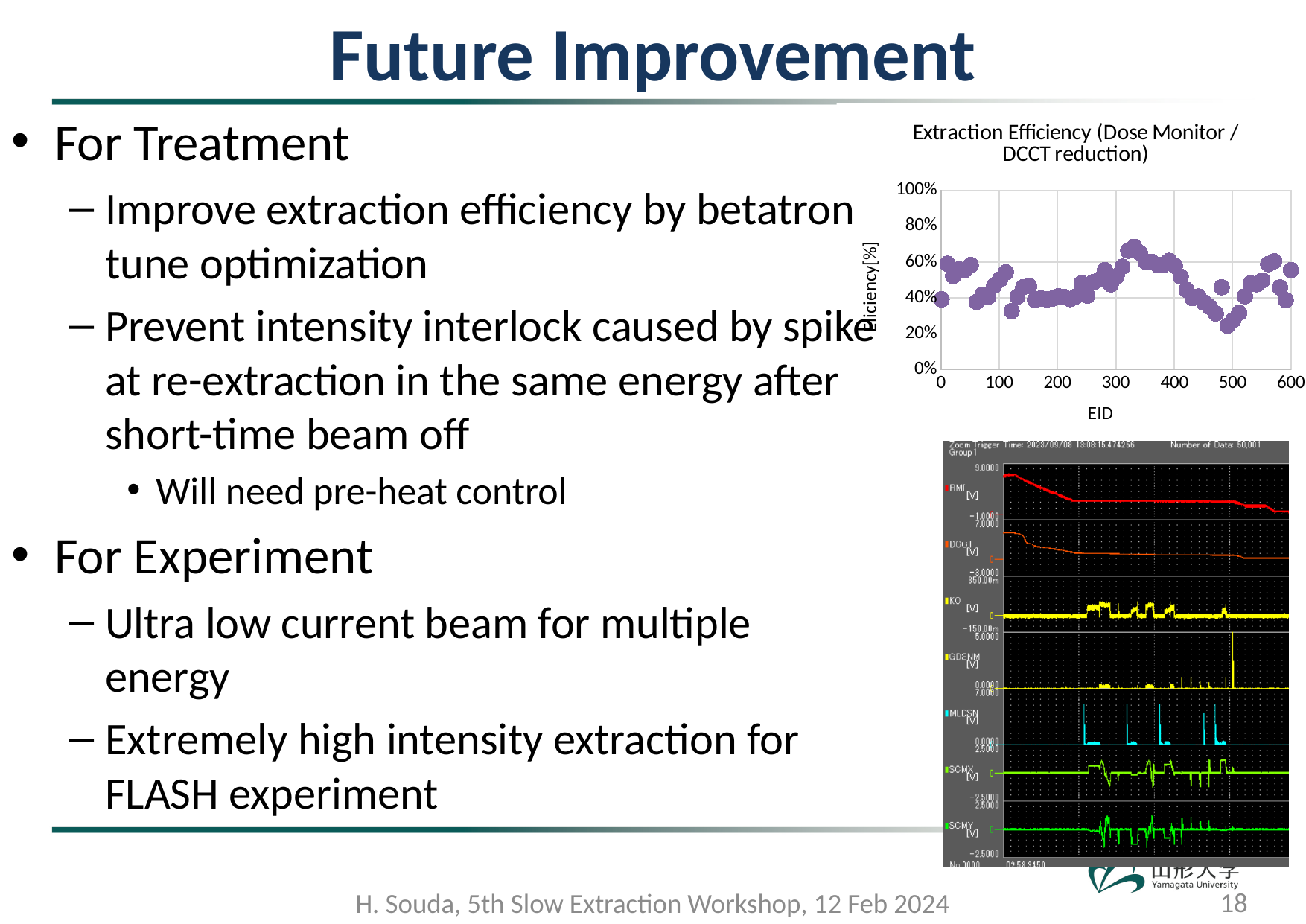
In the Extraction Efficiency chart, are the lowest points (around EID 490) greater or less than 40%? less In the Extraction Efficiency chart, are the points near EID 0 greater or less than 20%? greater In the Extraction Efficiency chart, is any plotted point greater than 80%? No In the Extraction Efficiency chart, what is the highest value shown on the y axis? 100% In the Extraction Efficiency chart, what is the largest EID value shown on the x axis? 600 What is the title of the chart in the upper right of the slide? Extraction Efficiency (Dose Monitor / DCCT reduction) In the Extraction Efficiency chart, is the efficiency around EID 330 higher or lower than around EID 490? higher In the Extraction Efficiency chart, what is the label of the x axis? EID What kind of chart is the Extraction Efficiency chart on the right of the slide? scatter chart